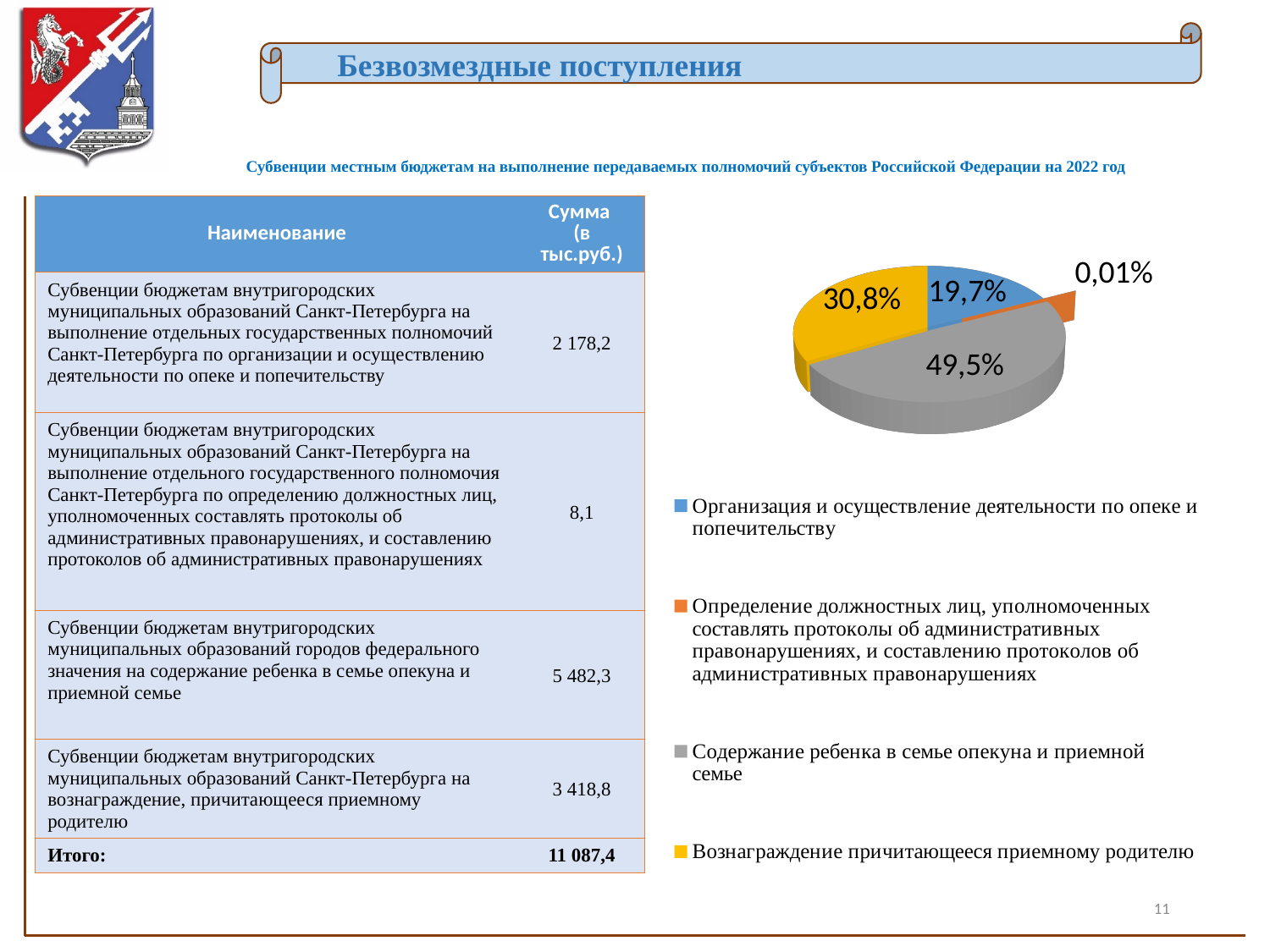
How many entries does the legend of the pie chart list? 4 What share of the pie does "Организация и осуществление деятельности по опеке и попечительству" have? 19,7% What colour is the slice for "Содержание ребенка в семье опекуна и приемной семье" in the pie chart? grey How many slices does the pie chart have? 4 What share of the pie does "Определение должностных лиц, уполномоченных составлять протоколы об административных правонарушениях, и составлению протоколов об административных правонарушениях" have? 0,01% What is the difference in percentage points between the slice for "Содержание ребенка в семье опекуна и приемной семье" and the slice for "Вознаграждение причитающееся приемному родителю"? 18,7 What share of the pie does "Вознаграждение причитающееся приемному родителю" have? 30,8% What share of the pie does "Содержание ребенка в семье опекуна и приемной семье" have? 49,5% Which category has the smallest slice of the pie chart? Определение должностных лиц, уполномоченных составлять протоколы об административных правонарушениях, и составлению протоколов об административных правонарушениях Which category has the largest slice of the pie chart? Содержание ребенка в семье опекуна и приемной семье What kind of chart is shown on the slide? pie chart Which slice is larger: "Вознаграждение причитающееся приемному родителю" or "Организация и осуществление деятельности по опеке и попечительству"? Вознаграждение причитающееся приемному родителю